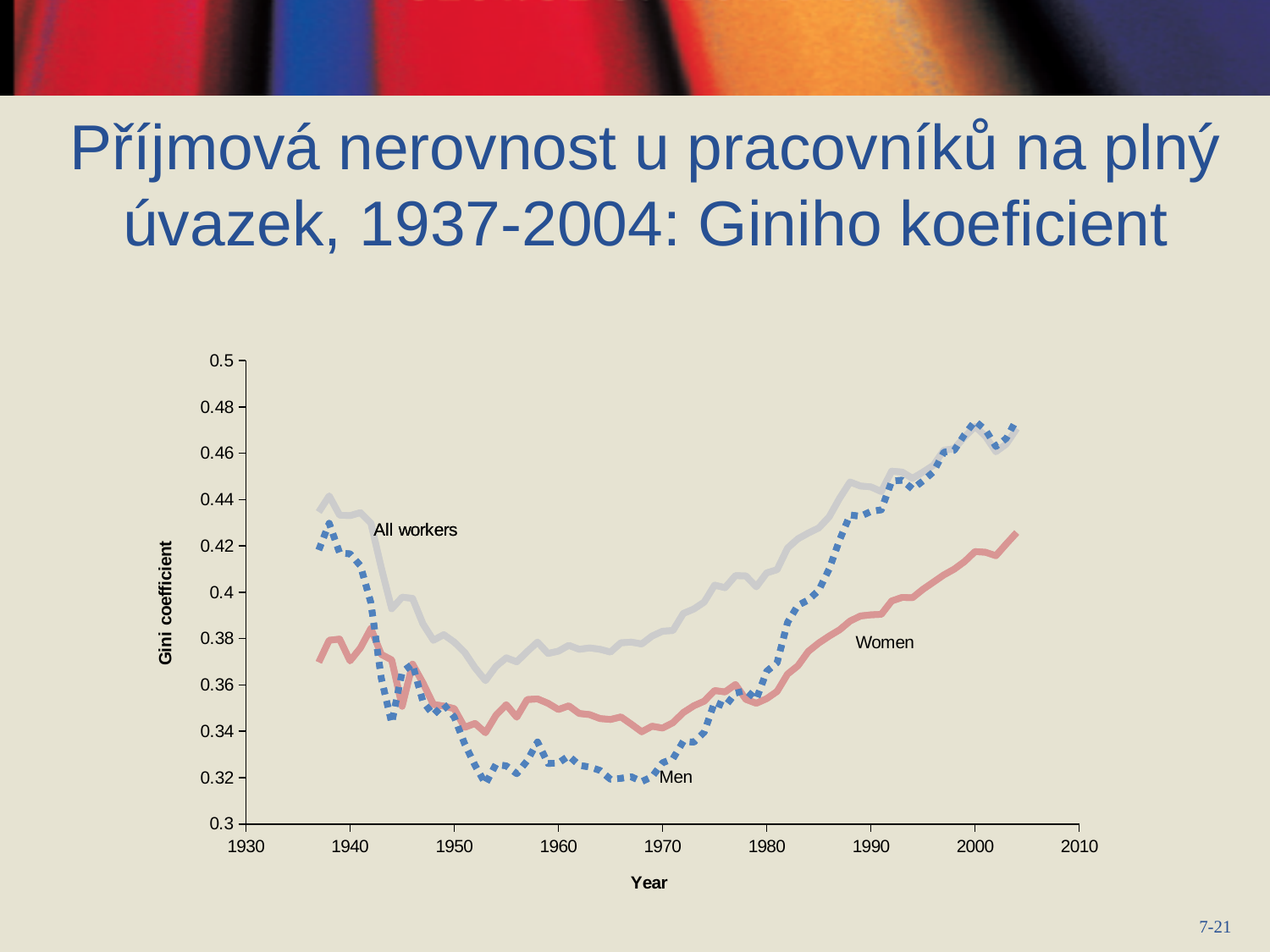
In 1990, which series has the higher value, Men or Women? Men Is the value for All workers in 1953 greater or less than 0.38? less What is the title of the horizontal axis? Year In 1960, which series has the higher value, All workers or Men? All workers What is the title of the vertical axis? Gini coefficient What kind of chart is shown on the slide? line chart Does the Men series rise or fall between 1980 and 2000? rise Is the value for Men in 1990 greater or less than 0.42? greater Which series has the lowest value in 2000? Women Is the value for Men in 1960 greater or less than 0.34? less How many series are plotted on the chart? 3